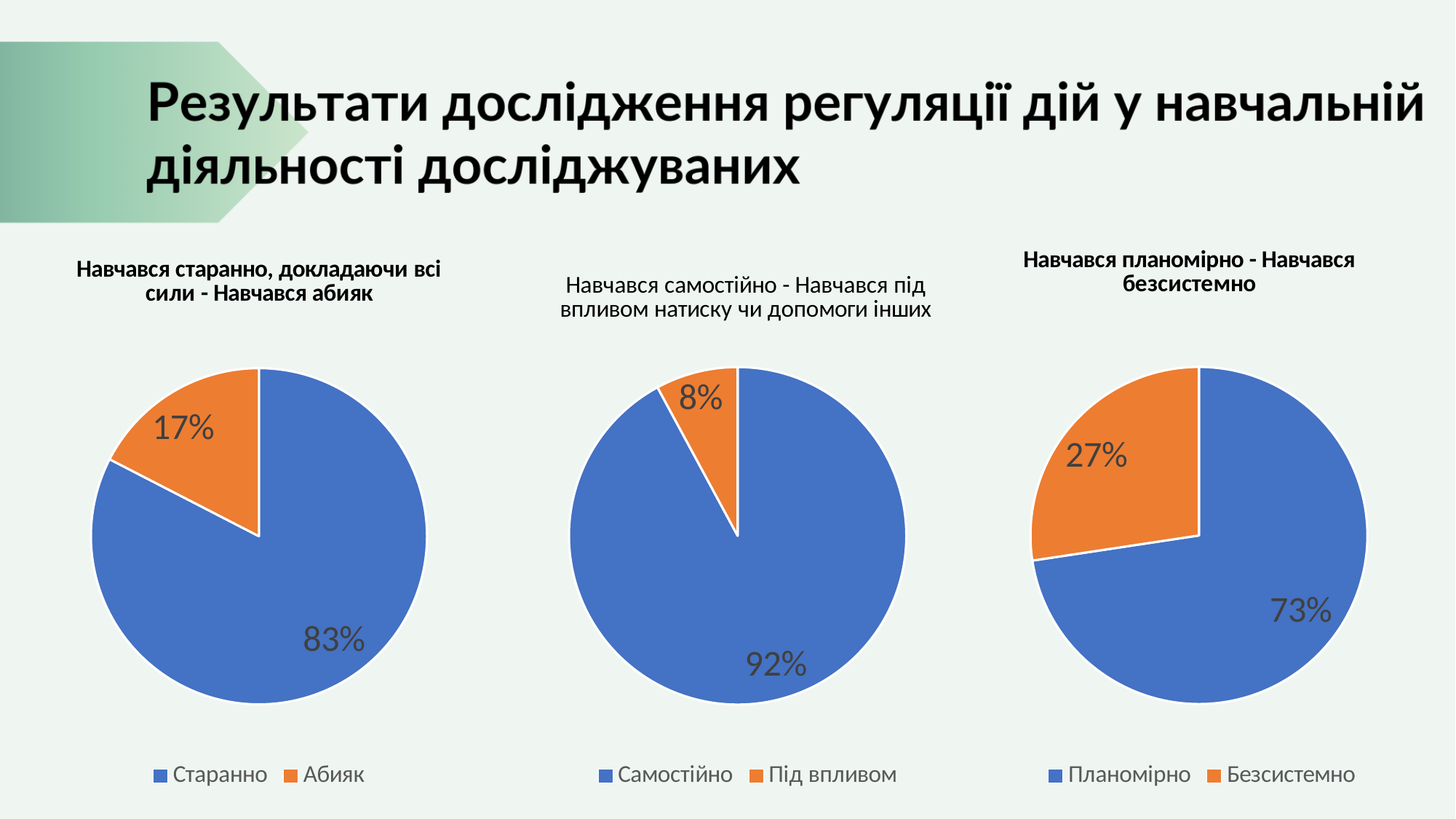
In the left pie chart (Навчався старанно, докладаючи всі сили - Навчався абияк), what share is labelled for Старанно? 83% In the right pie chart, which slice is the largest? Планомірно In the left pie chart, what is the difference between the Старанно and Абияк shares? 66% In the left pie chart, what share is labelled for Абияк? 17% What kind of chart is used for each of the three charts on the slide? Pie chart In the right pie chart, what share is labelled for Безсистемно? 27% How many entries does the legend of the middle pie chart list? 2 In the middle pie chart, what share is labelled for Під впливом? 8% In the middle pie chart, which slice is the smallest? Під впливом Which is larger: the Абияк share in the left pie chart or the Безсистемно share in the right pie chart? Безсистемно In the right pie chart (Навчався планомірно - Навчався безсистемно), what share is labelled for Планомірно? 73% In the middle pie chart (Навчався самостійно - Навчався під впливом натиску чи допомоги інших), what share is labelled for Самостійно? 92%